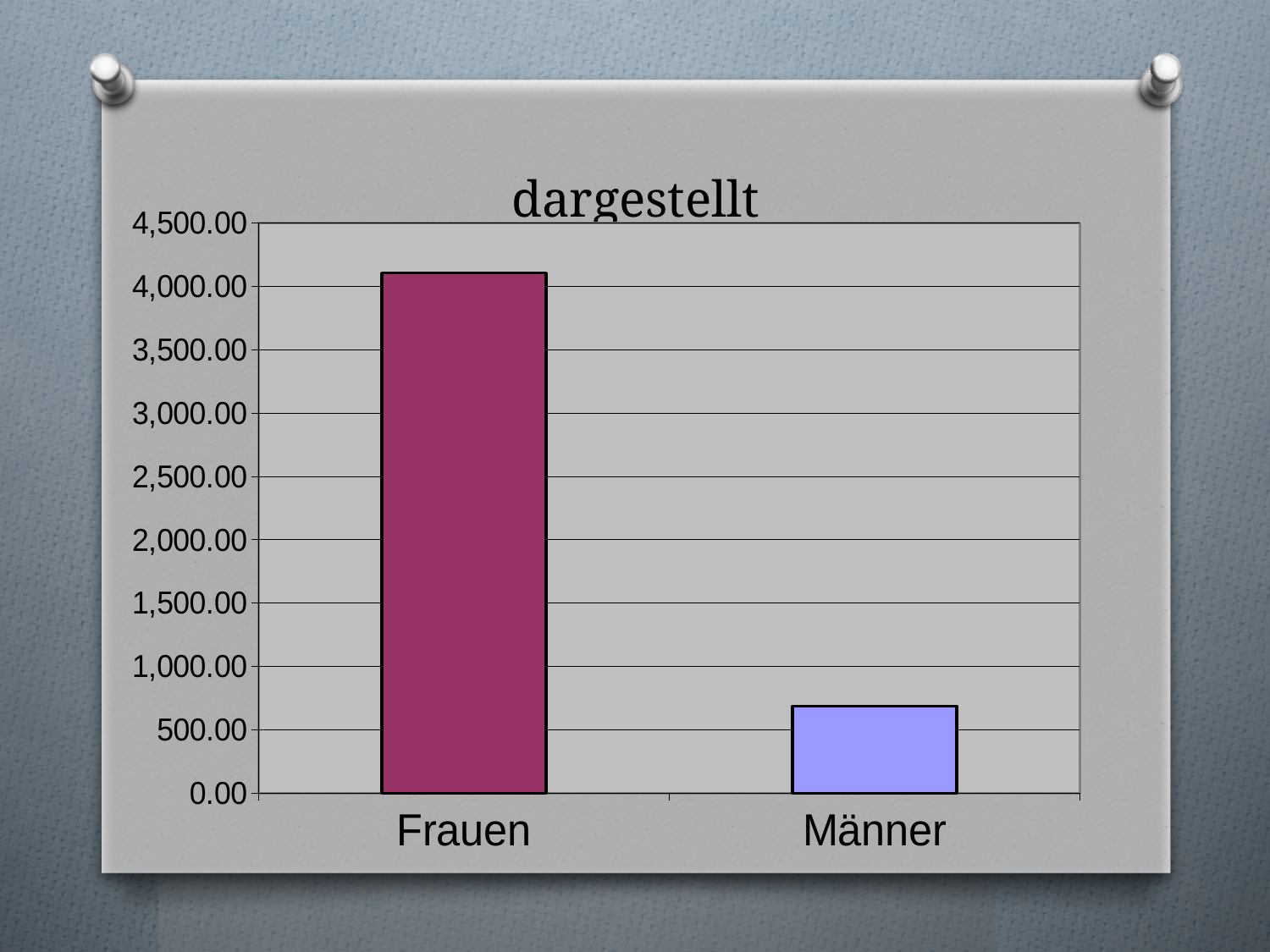
Which category has the lowest value? Männer Which is larger, the value for Frauen or the value for Männer? Frauen Is the value for Frauen greater or less than 4,000.00? greater How many categories are shown on the x axis? 2 What is the title of the chart? dargestellt Is the value for Männer greater or less than 500.00? greater Is the value for Männer greater or less than 1,000.00? less Which category has the highest value? Frauen What colour is the bar for Männer? light blue What is the highest value shown on the y axis? 4,500.00 What kind of chart is shown on the slide? bar chart